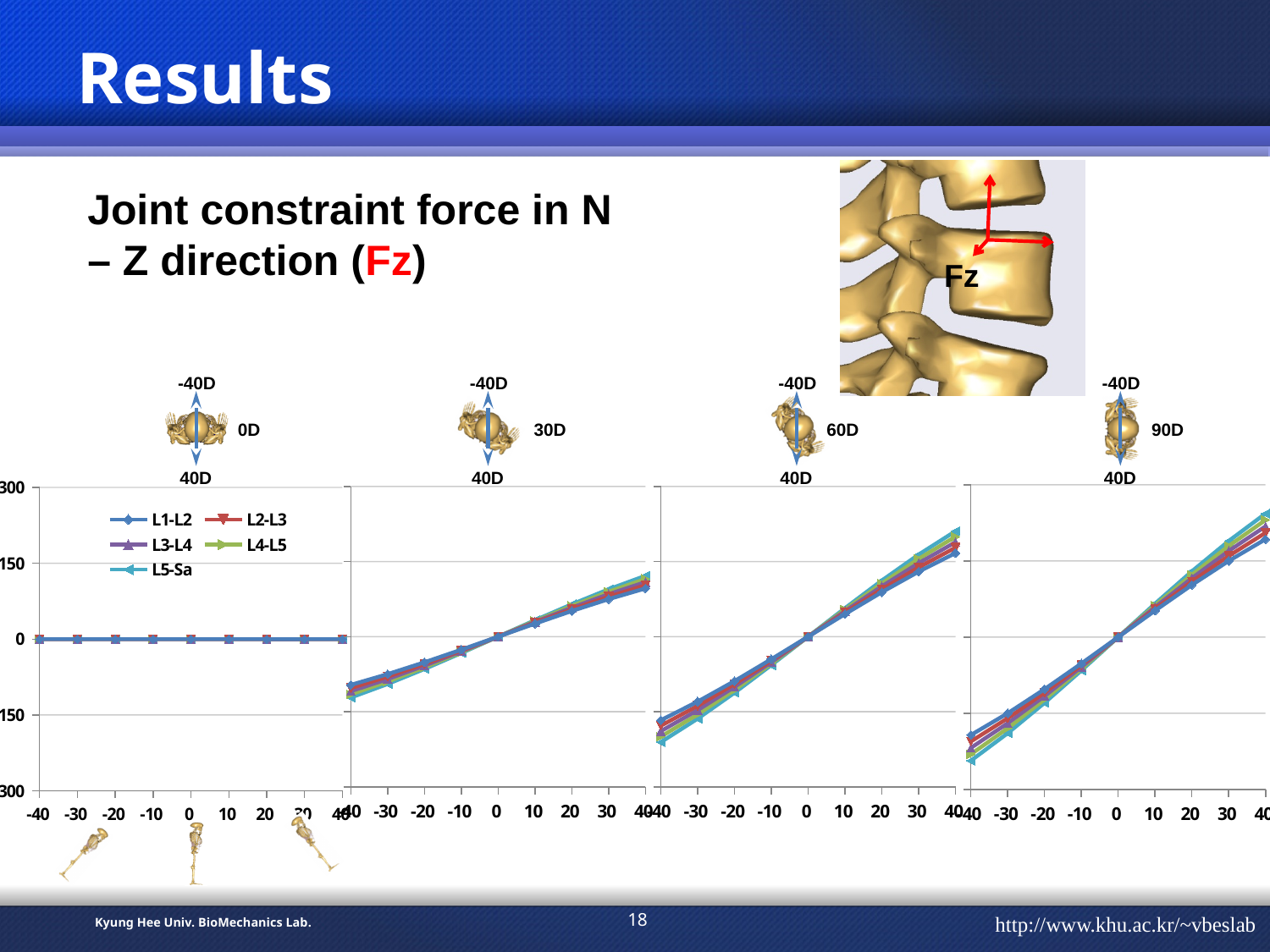
In the 0D chart, is the value for L2-L3 at x = 40 greater or less than 150? less What kind of chart is used in the 0D panel (leftmost chart)? line chart In the 30D chart, is the value for L1-L2 at x = 40 greater or less than 150? less Which series is listed last in the legend of the 0D chart? L5-Sa In the 60D chart, is the value for L5-Sa at x = -40 greater or less than -150? less How many x-axis points are plotted in the 30D chart? 9 In the 0D chart, what is the value of L1-L2 at x = 0? 0 In the 90D chart, which is larger at x = 40: L5-Sa or L1-L2? L5-Sa What quantity do the four charts show, according to the heading above them? Joint constraint force in N – Z direction (Fz) In the 30D chart, do the values rise or fall as x increases from -40 to 40? rise How many series does the legend in the 0D chart list? 5